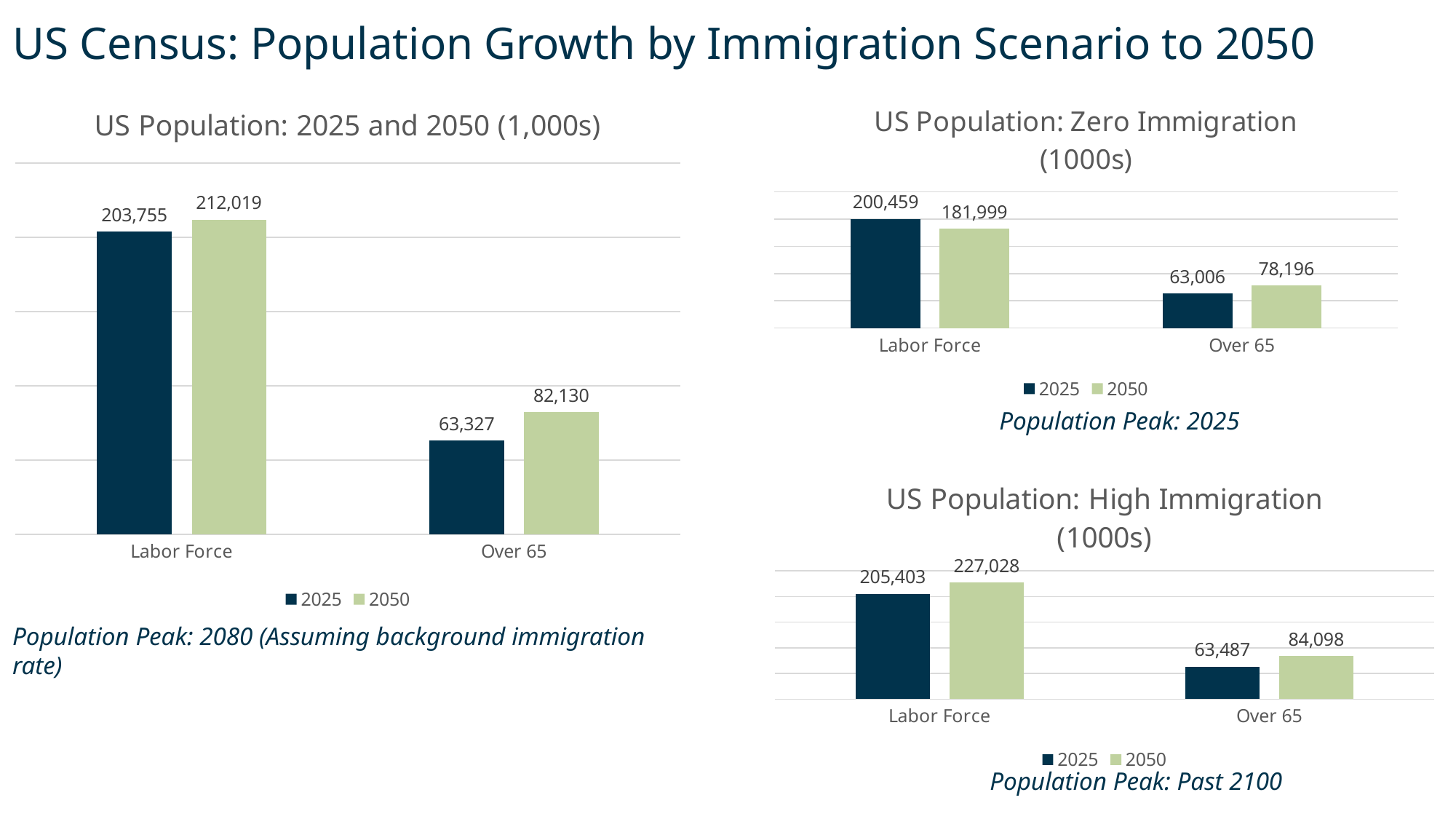
In the chart titled 'US Population: 2025 and 2050 (1,000s)', what is the value for Labor Force in 2025? 203,755 In the chart titled 'US Population: Zero Immigration (1000s)', what is the value for Labor Force in 2050? 181,999 In the chart titled 'US Population: Zero Immigration (1000s)', what is the difference between the 2025 and 2050 values for Labor Force? 18,460 In the chart titled 'US Population: High Immigration (1000s)', what is the value for Over 65 in 2025? 63,487 In the chart titled 'US Population: 2025 and 2050 (1,000s)', what is the difference between the 2050 and 2025 values for Labor Force? 8,264 In the chart titled 'US Population: Zero Immigration (1000s)', which is larger for Labor Force, the 2025 value or the 2050 value? 2025 In the chart titled 'US Population: High Immigration (1000s)', which bar is the highest? Labor Force, 2050 How many series does the legend list in the chart titled 'US Population: Zero Immigration (1000s)'? 2 In the chart titled 'US Population: 2025 and 2050 (1,000s)', what is the value for Over 65 in 2050? 82,130 In the chart titled 'US Population: High Immigration (1000s)', what is the value for Labor Force in 2050? 227,028 What kind of chart is the chart titled 'US Population: 2025 and 2050 (1,000s)'? Bar chart In the chart titled 'US Population: High Immigration (1000s)', what is the difference between the 2050 and 2025 values for Over 65? 20,611